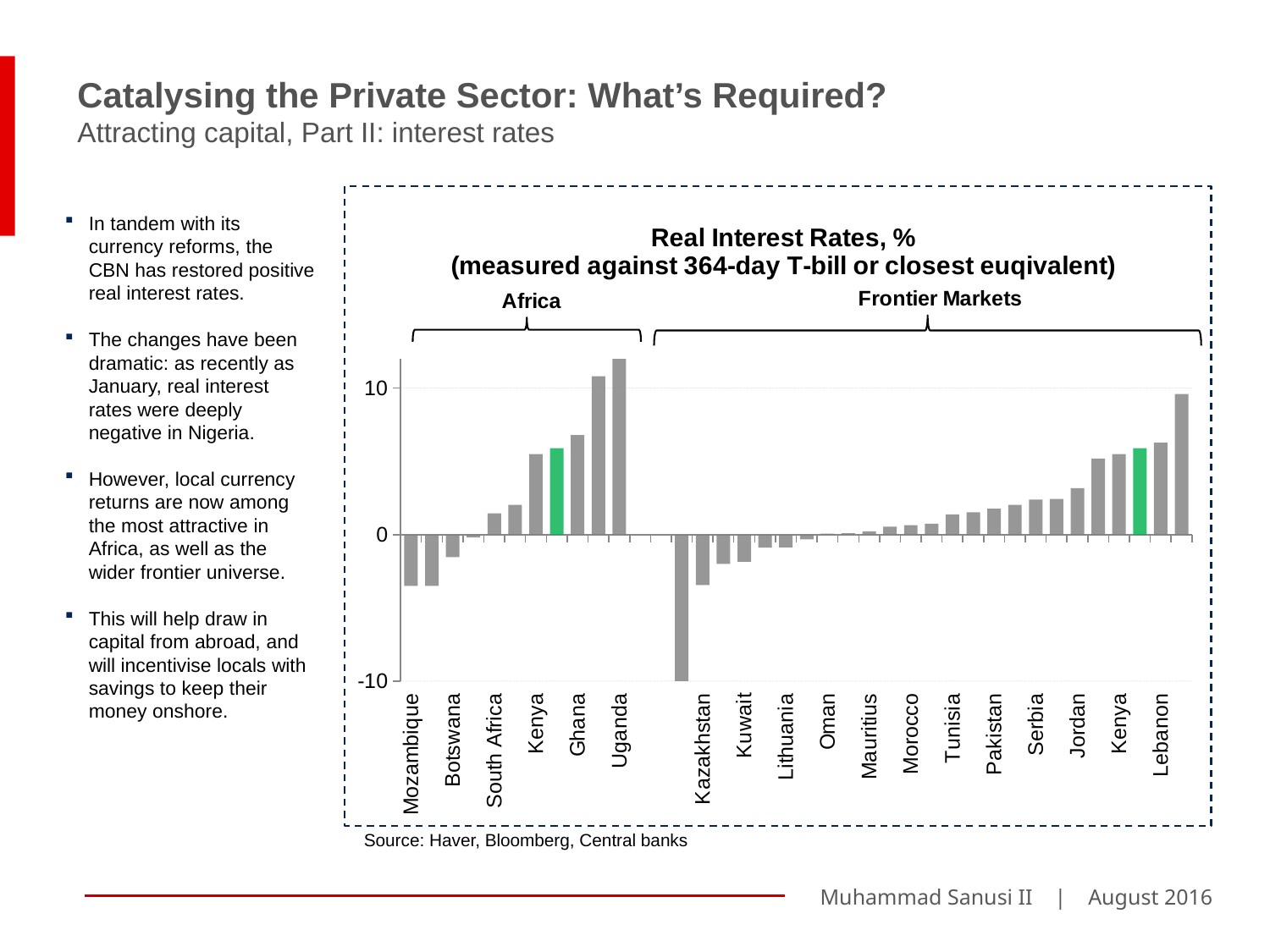
Is the real interest rate for Kuwait greater or less than 0? less What is the title of the chart? Real Interest Rates, % (measured against 364-day T-bill or closest euqivalent) Within the Frontier Markets group, do the bars rise or fall from left to right? Rise Is the real interest rate for Jordan greater or less than 0? greater Is the real interest rate for Mozambique greater or less than 0? less Which has the higher real interest rate, Uganda or Lebanon? Uganda What are the two groups the bars are divided into on the chart? Africa and Frontier Markets What kind of chart is shown on the slide? Bar chart Which has the higher real interest rate, Uganda or Ghana? Uganda Which country has the highest real interest rate on the chart? Uganda